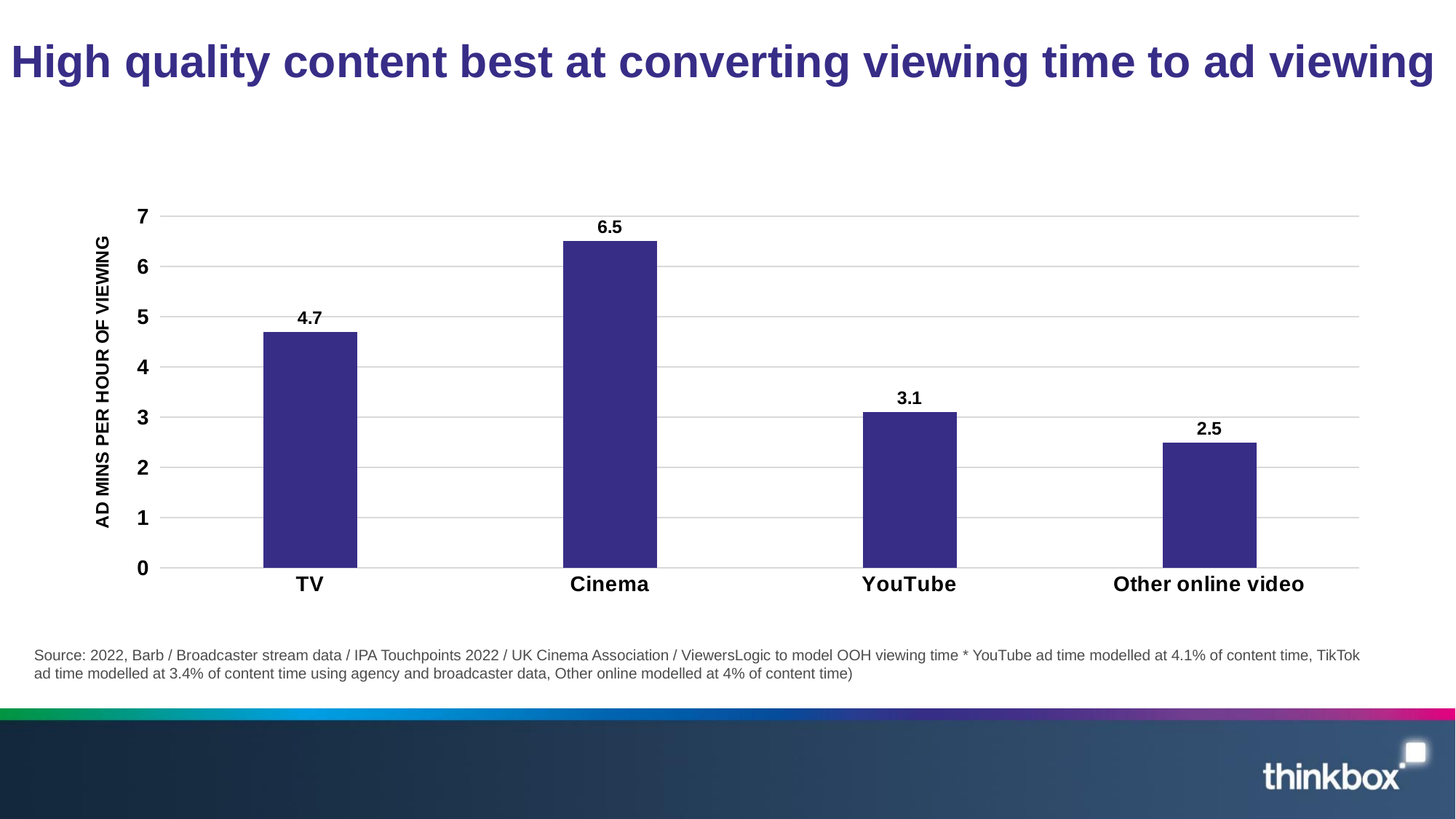
What is the difference between the values for YouTube and Other online video? 0.6 What is the difference between the values for Cinema and TV? 1.8 What is the value for YouTube? 3.1 What is the value for TV? 4.7 Which is larger, the value for TV or the value for YouTube? TV What is the value for Cinema? 6.5 What kind of chart is shown on the slide? Bar chart Which category has the highest value? Cinema Which category has the lowest value? Other online video What is the value for Other online video? 2.5 How many categories are shown on the x axis? 4 What is the label of the vertical axis? AD MINS PER HOUR OF VIEWING